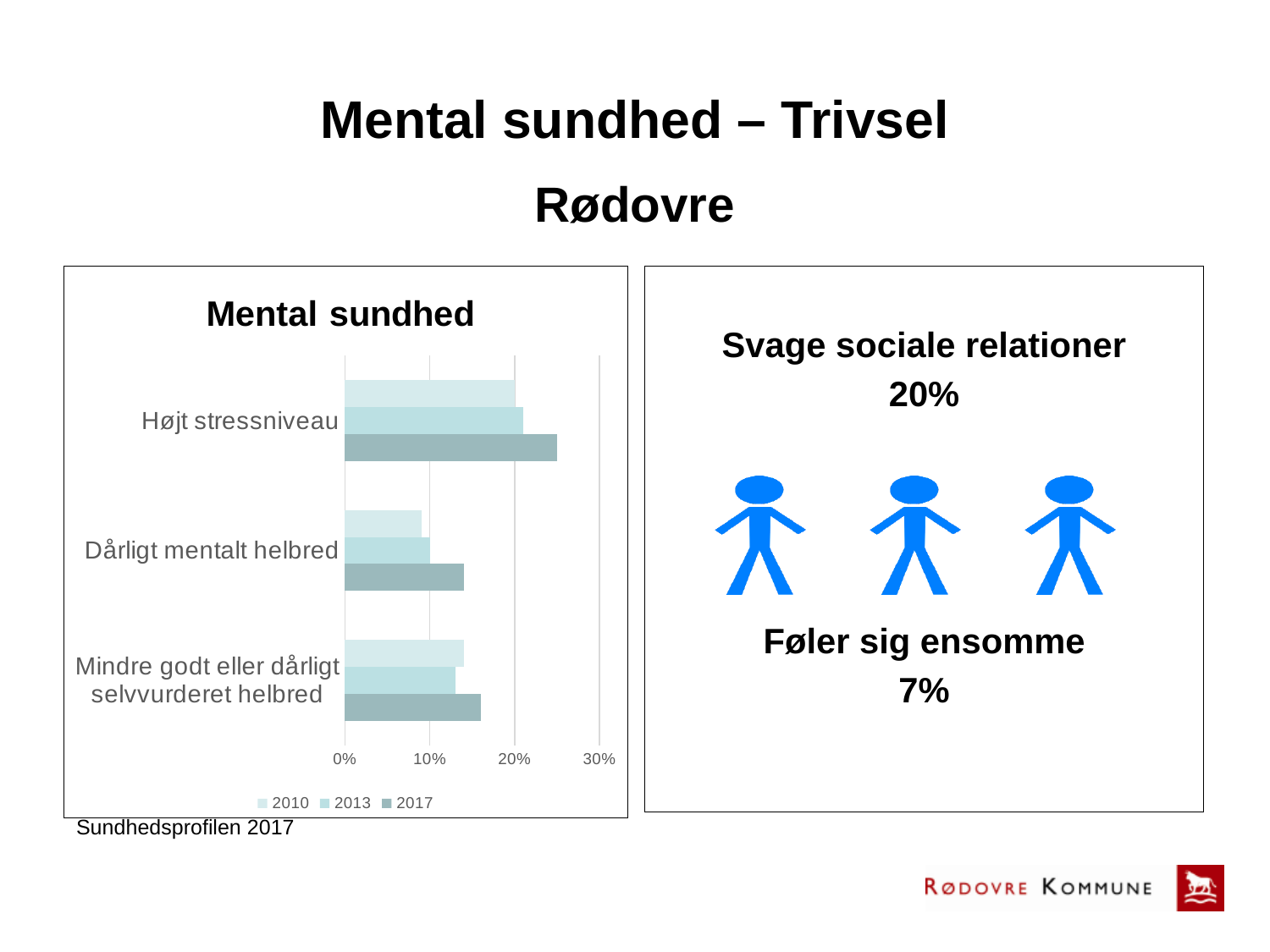
What is the title of the chart on the slide? Mental sundhed Is the 2017 value for Dårligt mentalt helbred greater or less than 10%? greater Is the 2010 value for Dårligt mentalt helbred greater or less than 10%? less For Højt stressniveau, which year has the larger value, 2010 or 2017? 2017 Which category has the lowest value for 2010 in the "Mental sundhed" chart? Dårligt mentalt helbred Which years are listed in the legend of the "Mental sundhed" chart? 2010, 2013, 2017 How many series does the legend of the "Mental sundhed" chart list? 3 What kind of chart is shown on the slide? Bar chart Is the 2017 value for Mindre godt eller dårligt selvvurderet helbred greater or less than 20%? less How many categories does the "Mental sundhed" chart show? 3 Which category has the highest value for 2017 in the "Mental sundhed" chart? Højt stressniveau